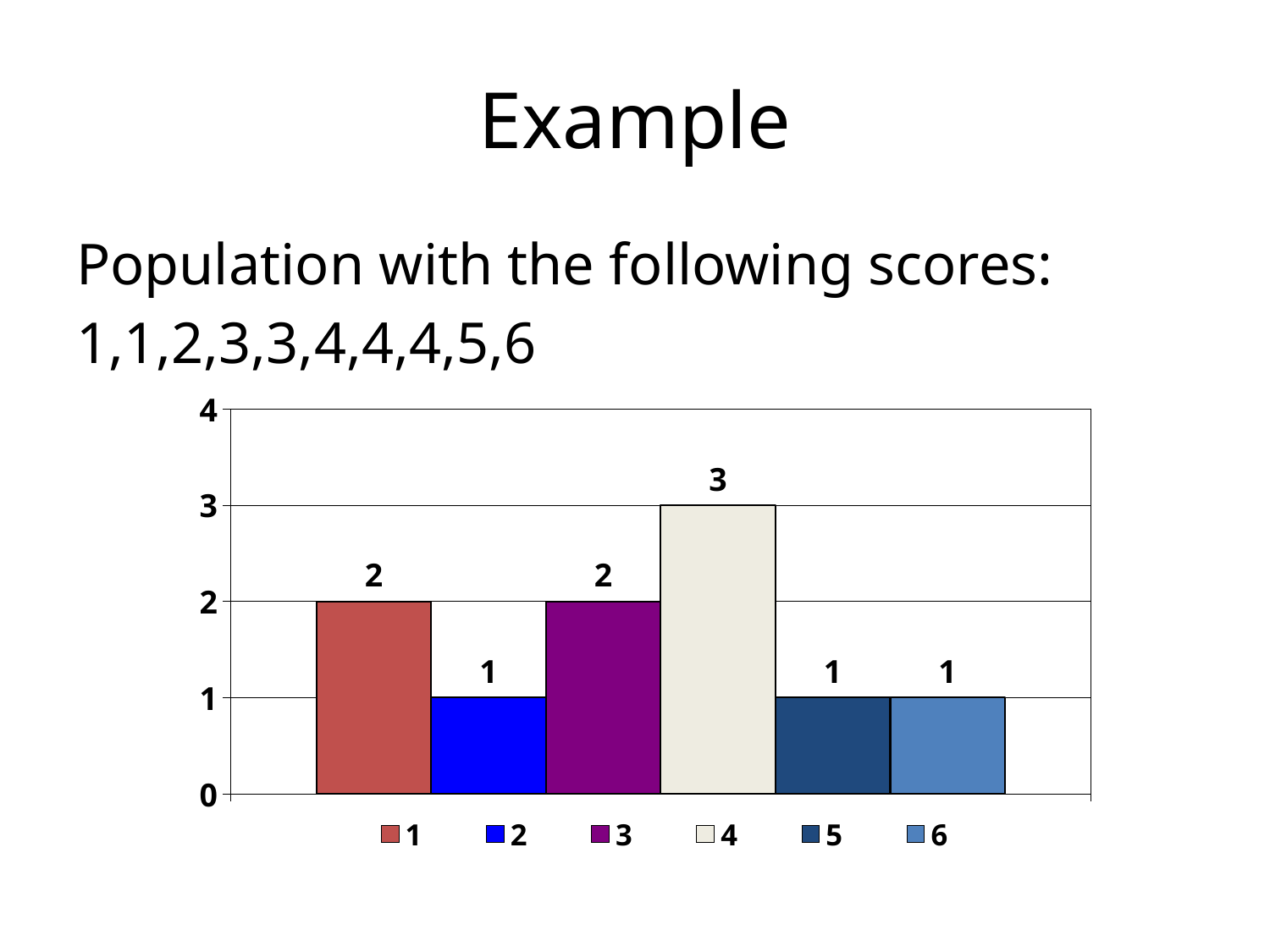
How many entries does the legend list? 6 What type of chart is shown on the slide? bar chart What is the difference between the bar for score 1 and the bar for score 5? 1 Which is larger, the bar for score 3 or the bar for score 6? score 3 What is the highest value shown on the vertical axis? 4 How many bars are plotted in the chart? 6 What is the value of the bar for score 4? 3 What is the value of the bar for score 5? 1 What colour is the bar for score 2 in the legend? blue Which score has the highest bar? 4 What is the value of the bar for score 1? 2 What is the difference between the bar for score 4 and the bar for score 2? 2